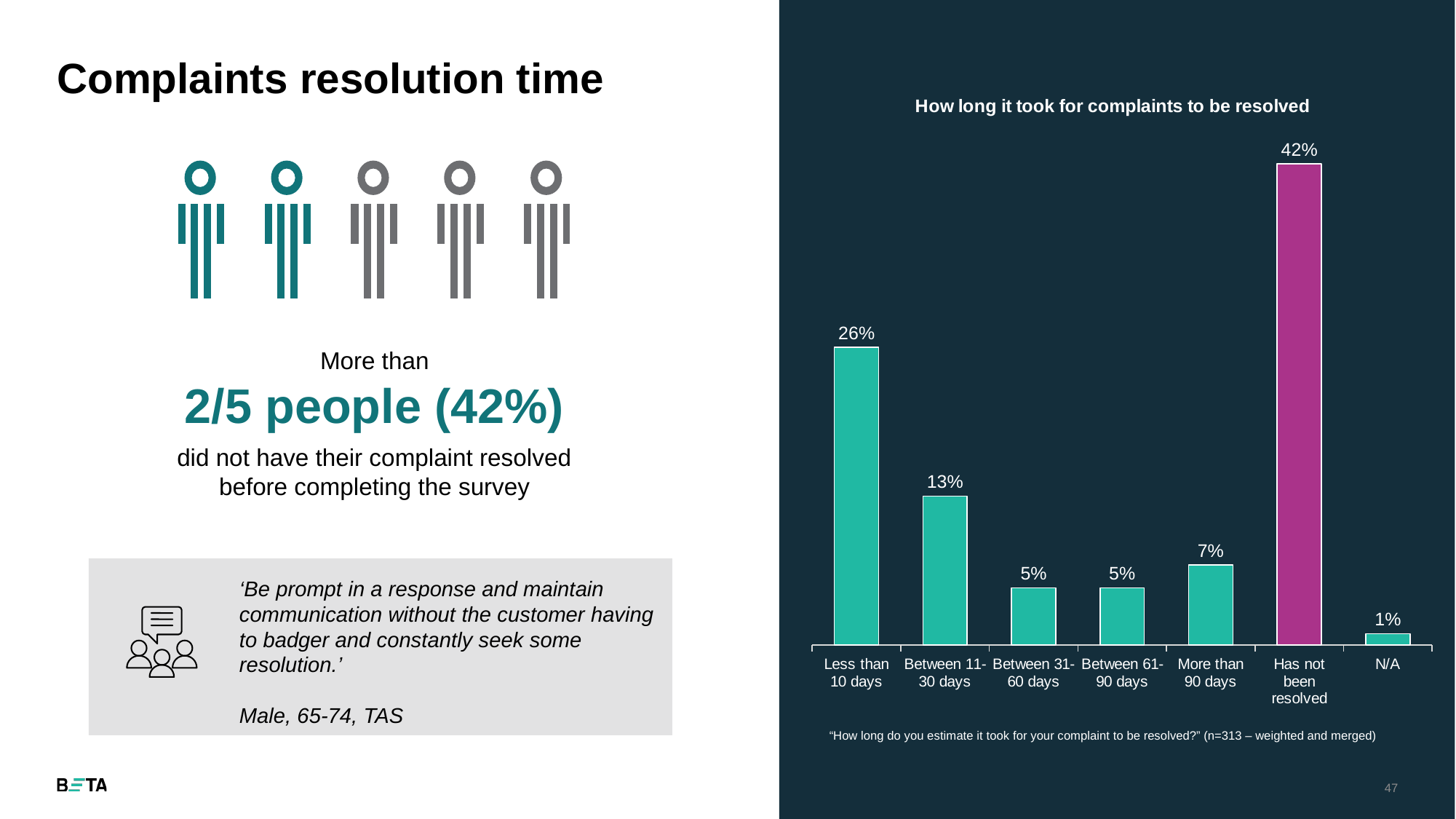
What percentage of complaints took more than 90 days to be resolved? 7% Which category has the highest value? Has not been resolved What is the value for the 'N/A' category? 1% What percentage of complaints were resolved in less than 10 days? 26% Which bar is coloured differently (magenta) from the others? Has not been resolved What is the value for 'Between 11-30 days'? 13% How many categories are shown on the x axis? 7 What is the difference between 'Has not been resolved' and 'Less than 10 days'? 16 percentage points Which category has the lowest value? N/A Which is larger: 'Between 11-30 days' or 'More than 90 days'? Between 11-30 days What is the title of the chart? How long it took for complaints to be resolved What kind of chart is shown on the slide? Bar chart